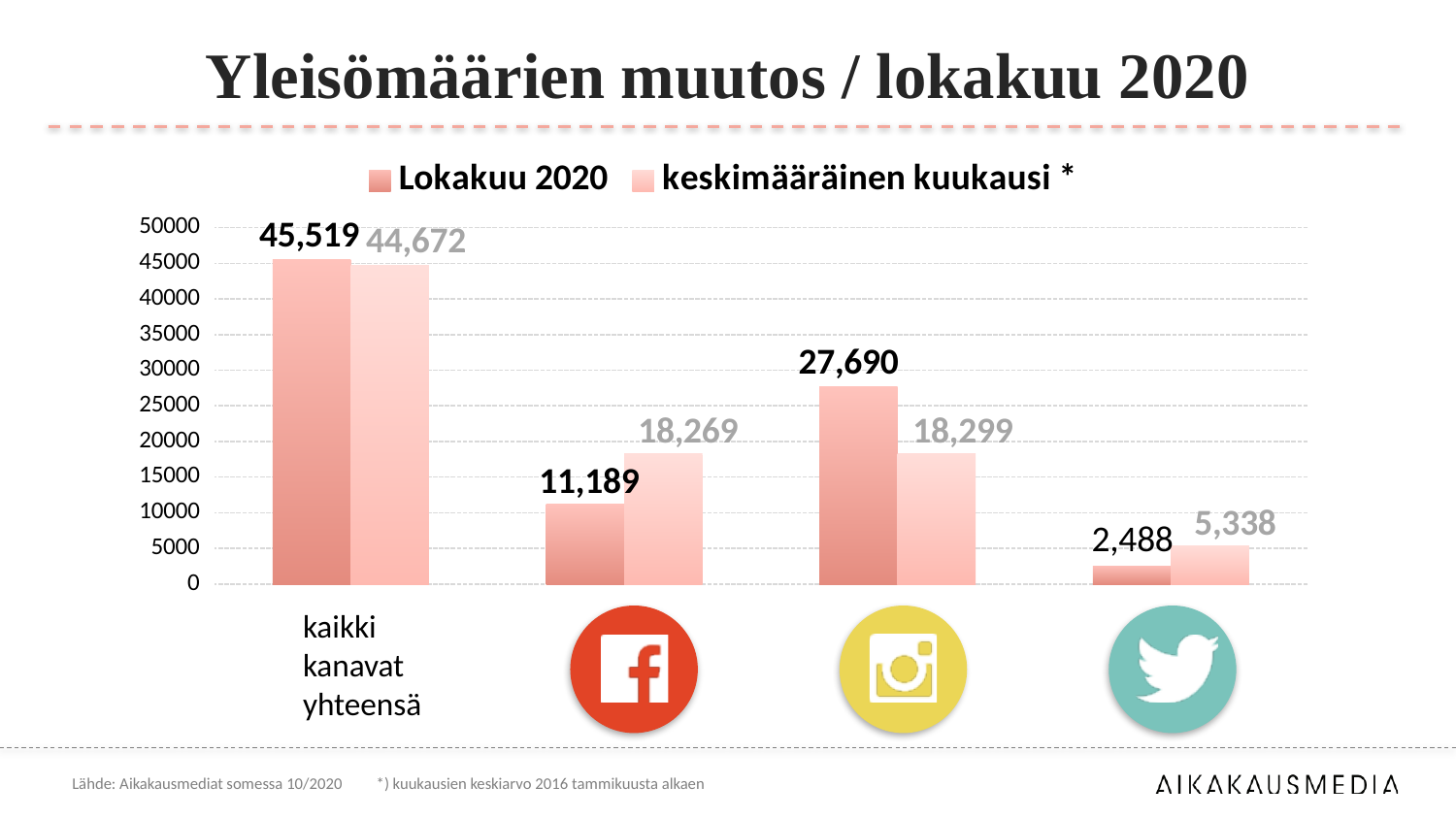
How many series does the legend list? 2 What is the title of the chart slide? Yleisömäärien muutos / lokakuu 2020 What is the 'keskimääräinen kuukausi *' value for the Twitter category (rightmost)? 5,338 Which is larger for the Instagram category (third from the left): the Lokakuu 2020 value or the 'keskimääräinen kuukausi *' value? Lokakuu 2020 What is the 'keskimääräinen kuukausi *' value for 'kaikki kanavat yhteensä'? 44,672 Which category has the highest Lokakuu 2020 value? kaikki kanavat yhteensä What is the Lokakuu 2020 value for the Instagram category (third from the left)? 27,690 What is the difference between the 'keskimääräinen kuukausi *' value and the Lokakuu 2020 value for the Facebook category (second from the left)? 7,080 What is the Lokakuu 2020 value for 'kaikki kanavat yhteensä'? 45,519 Which category has the lowest Lokakuu 2020 value? Twitter (rightmost category) What type of chart is shown on the slide? Bar chart How many categories are shown on the x axis? 4